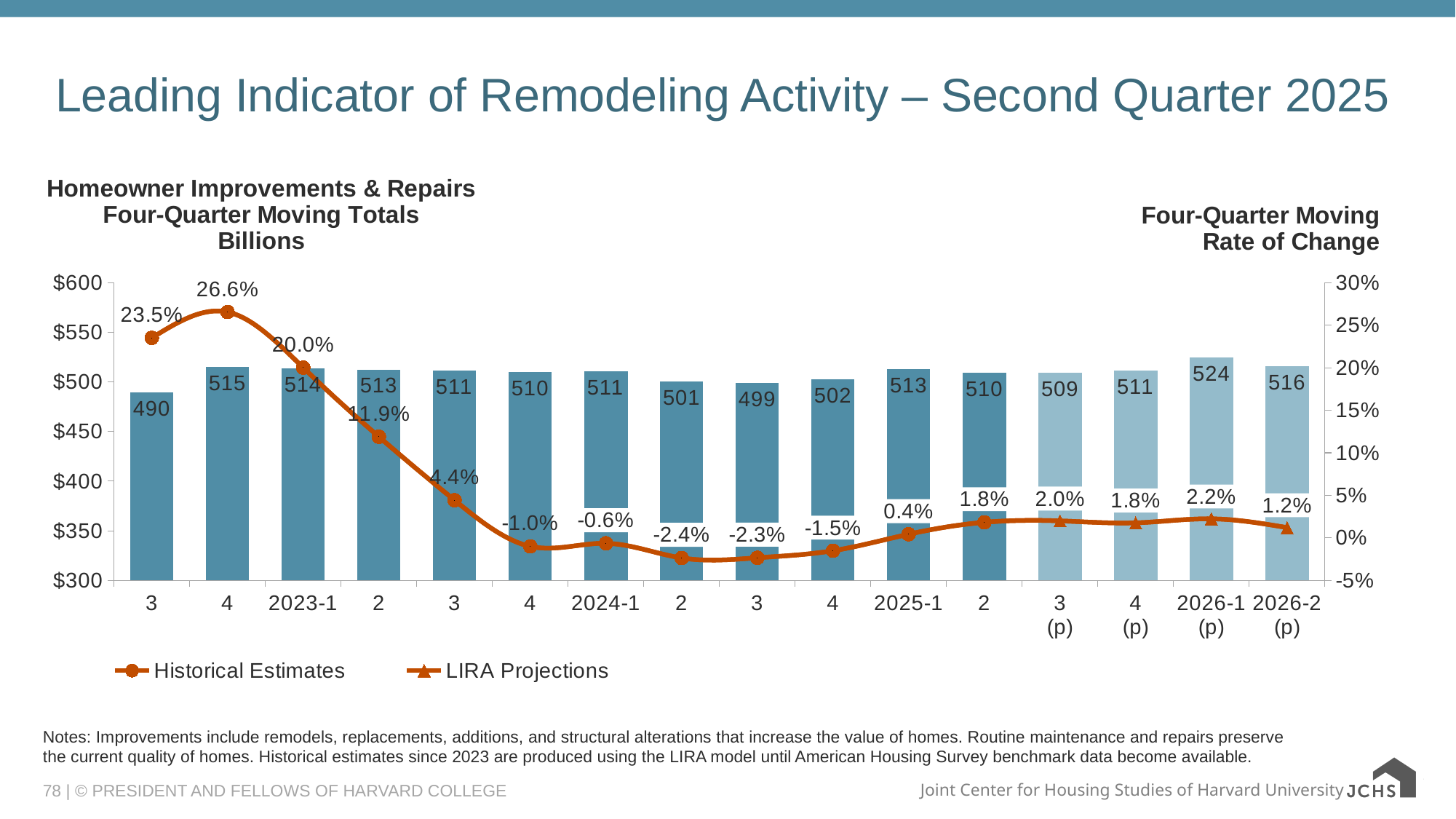
What is the four-quarter moving rate of change for 2025-1? 0.4% How many bars are plotted on the chart? 16 What is the four-quarter moving total (in billions) for 2026-1 (p)? 524 Does the four-quarter moving rate of change rise or fall from quarter 4 (26.6%) to quarter 2 of 2024? Fall Which quarter has the highest four-quarter moving total bar? 2026-1 (p) What is the difference between the four-quarter moving totals for 2026-1 (p) and 2025-1? 11 Which has the larger four-quarter moving total, 2024-1 or quarter 2 of 2024? 2024-1 What is the four-quarter moving rate of change for quarter 2 of 2024? -2.4% What is the highest four-quarter moving rate of change shown on the line? 26.6% What is the lowest four-quarter moving total shown on the bars? 490 What kind of chart is shown on the slide? A bar chart combined with a line chart How many series does the legend list? 2